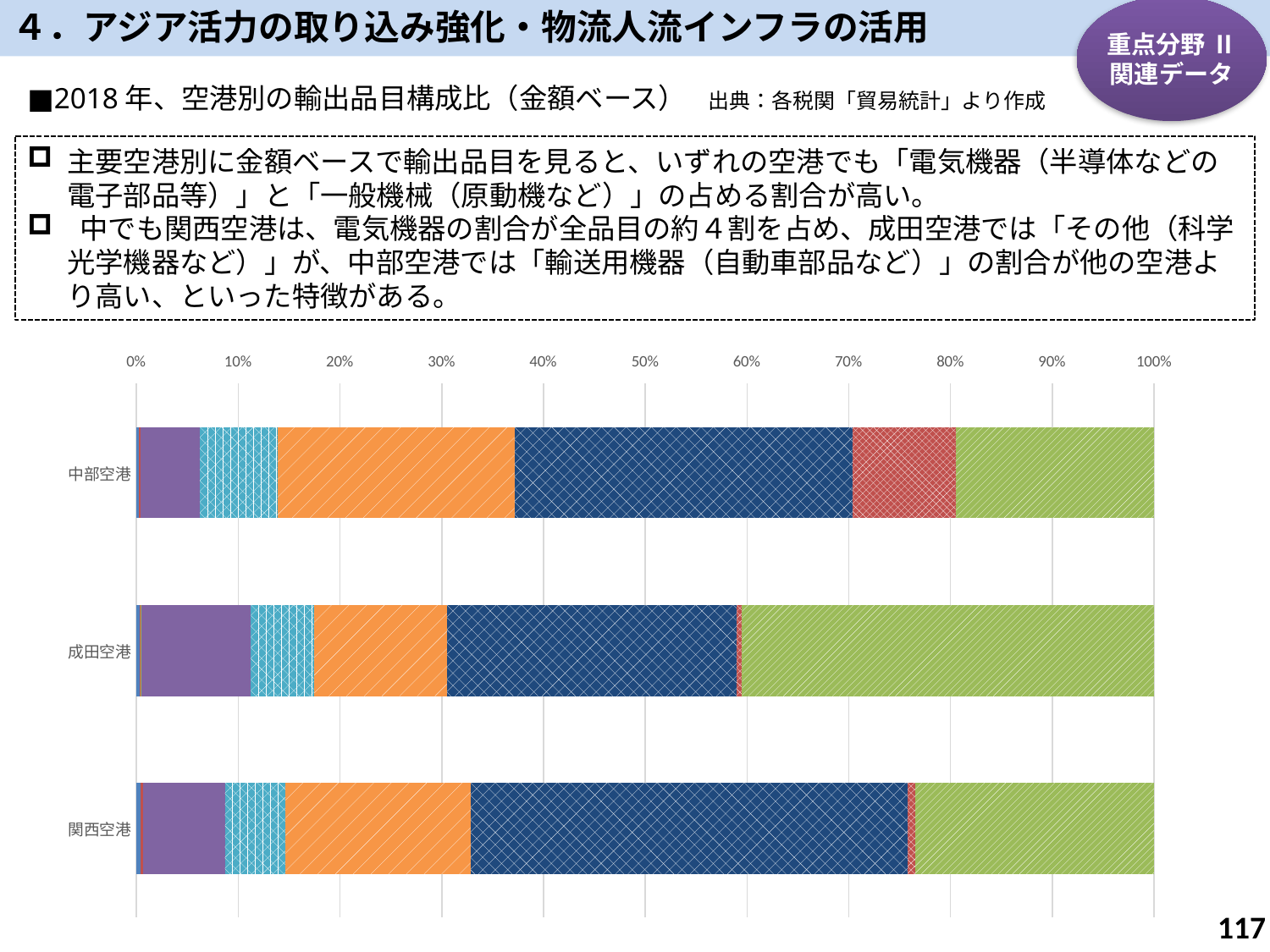
Which airport has the widest dark blue segment in its bar? 関西空港 How many airports (categories) are plotted on the chart? 3 What kind of chart is shown on the slide? Stacked bar chart Is the green segment for 成田空港 greater or less than 30% of the bar? greater What is the maximum value shown on the horizontal axis? 100% Is the dark blue segment for 関西空港 greater or less than 40% of the bar? greater Which airport is listed at the top of the chart? 中部空港 Which airport has the widest red segment in its bar? 中部空港 Which airport has the widest green segment in its bar? 成田空港 Is the orange segment for 中部空港 greater or less than 20% of the bar? greater